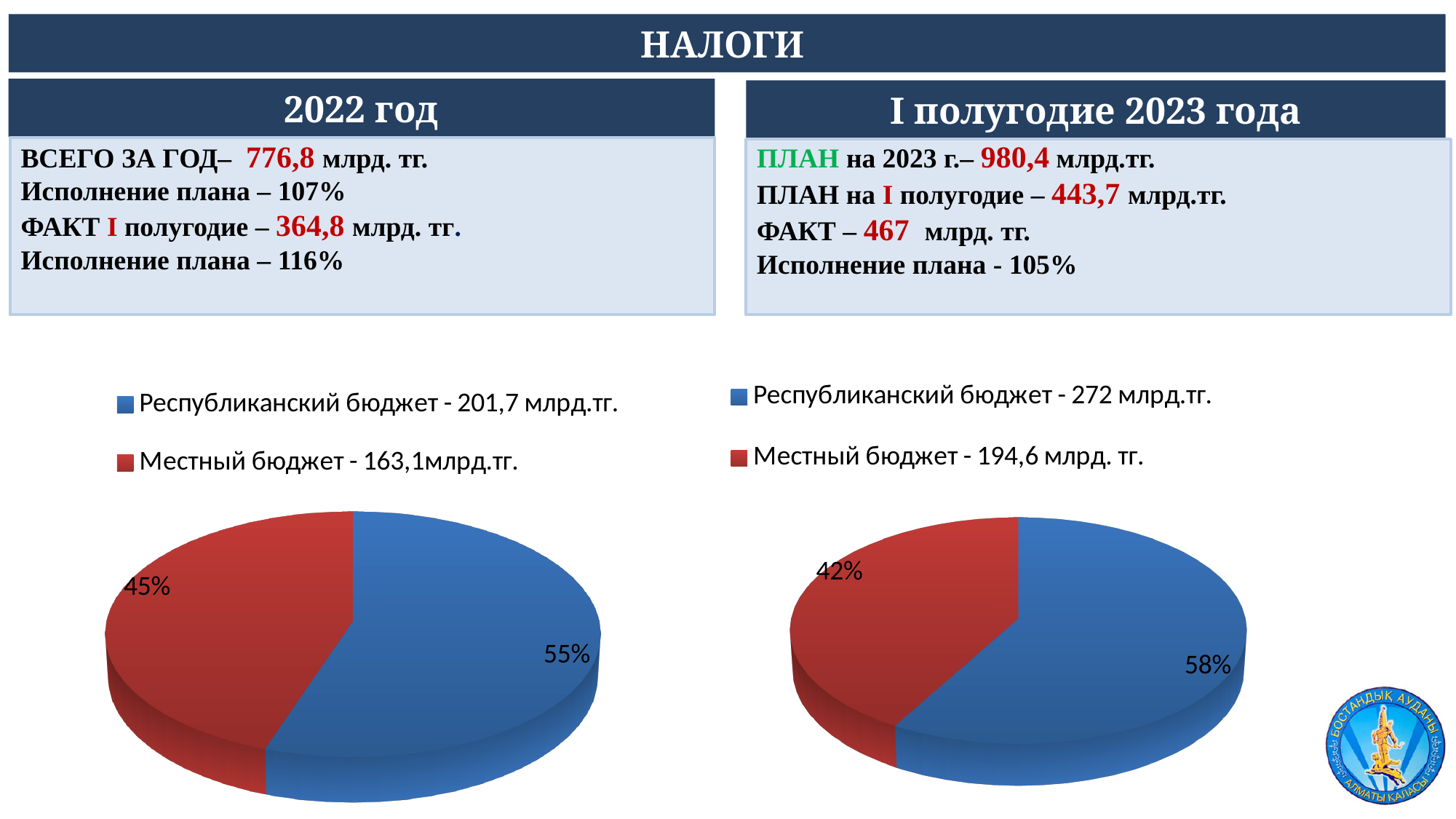
In the left pie chart (2022 год), what share does the Республиканский бюджет slice have? 55% In the left pie chart (2022 год), what share does the Местный бюджет slice have? 45% In the right pie chart (I полугодие 2023 года), what share does the Республиканский бюджет slice have? 58% In the left pie chart (2022 год), what is the difference in percentage points between the Республиканский бюджет and Местный бюджет slices? 10 In the right pie chart (I полугодие 2023 года), which slice is the smallest? Местный бюджет In the left pie chart (2022 год), which slice is larger, Республиканский бюджет or Местный бюджет? Республиканский бюджет In the right pie chart (I полугодие 2023 года), what is the difference in percentage points between the Республиканский бюджет and Местный бюджет slices? 16 How many slices does the right pie chart (I полугодие 2023 года) have? 2 What type of chart is used on the left side of the slide (2022 год)? Pie chart In the left pie chart (2022 год), what value does the legend give for Местный бюджет? 163,1 млрд.тг. In the right pie chart (I полугодие 2023 года), what colour is the Республиканский бюджет slice? Blue